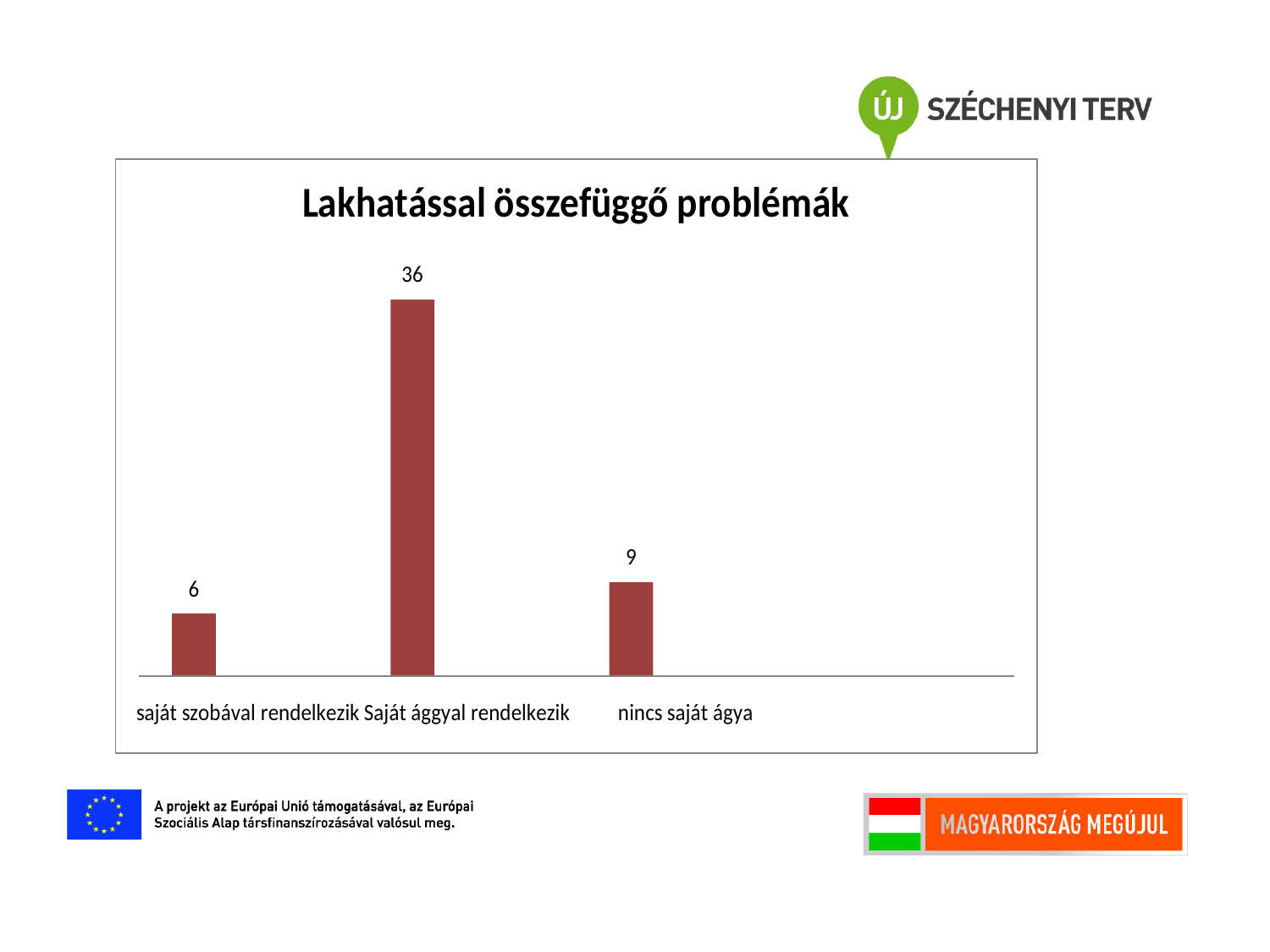
What is the difference between the values for "nincs saját ágya" and "saját szobával rendelkezik"? 3 What is the value for "nincs saját ágya"? 9 Which is larger: the value for "nincs saját ágya" or the value for "saját szobával rendelkezik"? nincs saját ágya What is the title of the chart? Lakhatással összefüggő problémák What is the difference between the values for "Saját ággyal rendelkezik" and "nincs saját ágya"? 27 Which category has the highest value? Saját ággyal rendelkezik What kind of chart is shown on the slide? bar chart What is the value for "Saját ággyal rendelkezik"? 36 What is the value for "saját szobával rendelkezik"? 6 How many categories are shown in the chart? 3 What colour are the bars in the chart? dark red Which category has the lowest value? saját szobával rendelkezik